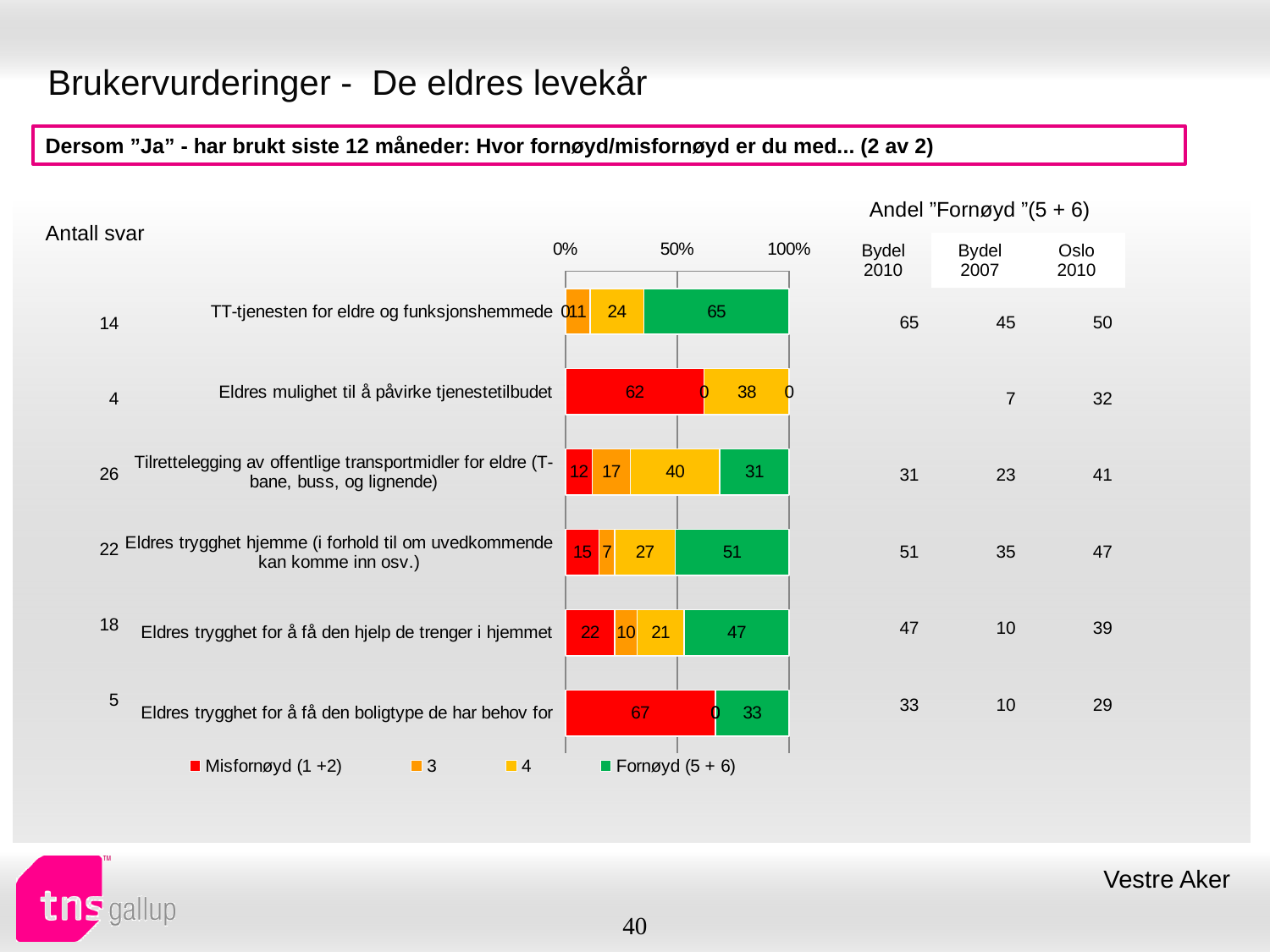
Which is larger: the Misfornøyd (1 +2) value for "Eldres mulighet til å påvirke tjenestetilbudet" or for "Eldres trygghet hjemme (i forhold til om uvedkommende kan komme inn osv.)"? Eldres mulighet til å påvirke tjenestetilbudet Which colour represents the Fornøyd (5 + 6) series in the chart? Green Which category has the highest Misfornøyd (1 +2) value? Eldres trygghet for å få den boligtype de har behov for How many categories are shown in the chart? 6 What is the value of the "4" segment for "Tilrettelegging av offentlige transportmidler for eldre (T-bane, buss, og lignende)"? 40 What is the value of the Misfornøyd (1 +2) segment for "Eldres trygghet for å få den boligtype de har behov for"? 67 What kind of chart is shown on the slide? Stacked bar chart How many series does the legend list? 4 What is the value of the "3" segment for "Eldres trygghet for å få den hjelp de trenger i hjemmet"? 10 What is the value of the Fornøyd (5 + 6) segment for "TT-tjenesten for eldre og funksjonshemmede"? 65 Which category has the highest Fornøyd (5 + 6) value? TT-tjenesten for eldre og funksjonshemmede What is the difference between the Fornøyd (5 + 6) values for "Eldres trygghet hjemme (i forhold til om uvedkommende kan komme inn osv.)" and "Eldres trygghet for å få den hjelp de trenger i hjemmet"? 4